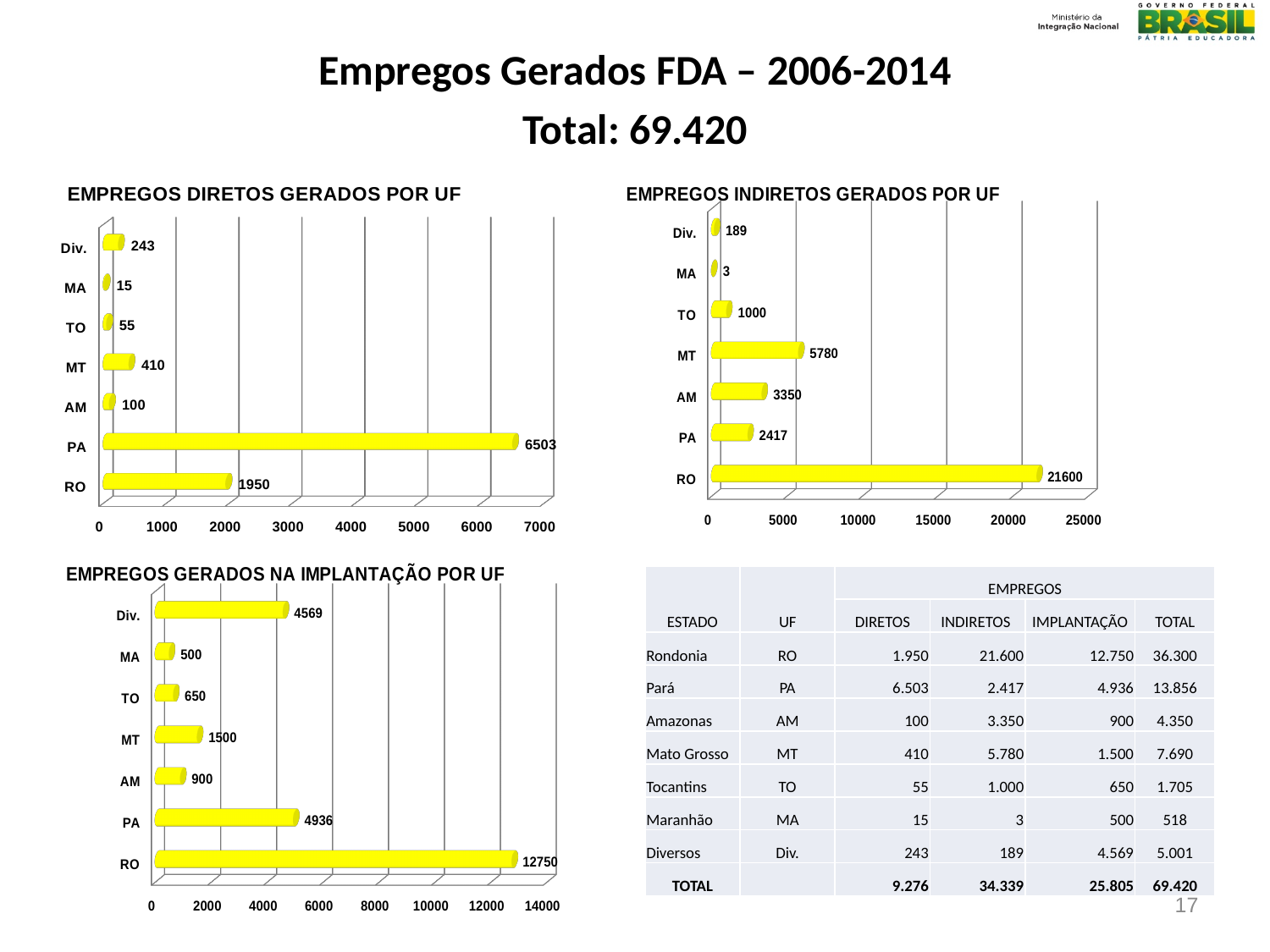
In the chart titled EMPREGOS INDIRETOS GERADOS POR UF, how many categories are plotted? 7 In the chart titled EMPREGOS GERADOS NA IMPLANTAÇÃO POR UF, what is the difference between the values for MT and AM? 600 In the chart titled EMPREGOS GERADOS NA IMPLANTAÇÃO POR UF, what is the value for Div.? 4569 In the chart titled EMPREGOS DIRETOS GERADOS POR UF, what is the value for PA? 6503 In the chart titled EMPREGOS INDIRETOS GERADOS POR UF, what is the value for MT? 5780 In the chart titled EMPREGOS INDIRETOS GERADOS POR UF, which category has the highest value? RO In the chart titled EMPREGOS DIRETOS GERADOS POR UF, what is the difference between the values for PA and RO? 4553 What kind of chart is the one titled EMPREGOS GERADOS NA IMPLANTAÇÃO POR UF? Bar chart In the chart titled EMPREGOS GERADOS NA IMPLANTAÇÃO POR UF, which category has the highest value? RO In the chart titled EMPREGOS DIRETOS GERADOS POR UF, which category has the lowest value? MA In the chart titled EMPREGOS INDIRETOS GERADOS POR UF, which is larger, the value for AM or the value for PA? AM In the chart titled EMPREGOS DIRETOS GERADOS POR UF, what colour are the bars? Yellow